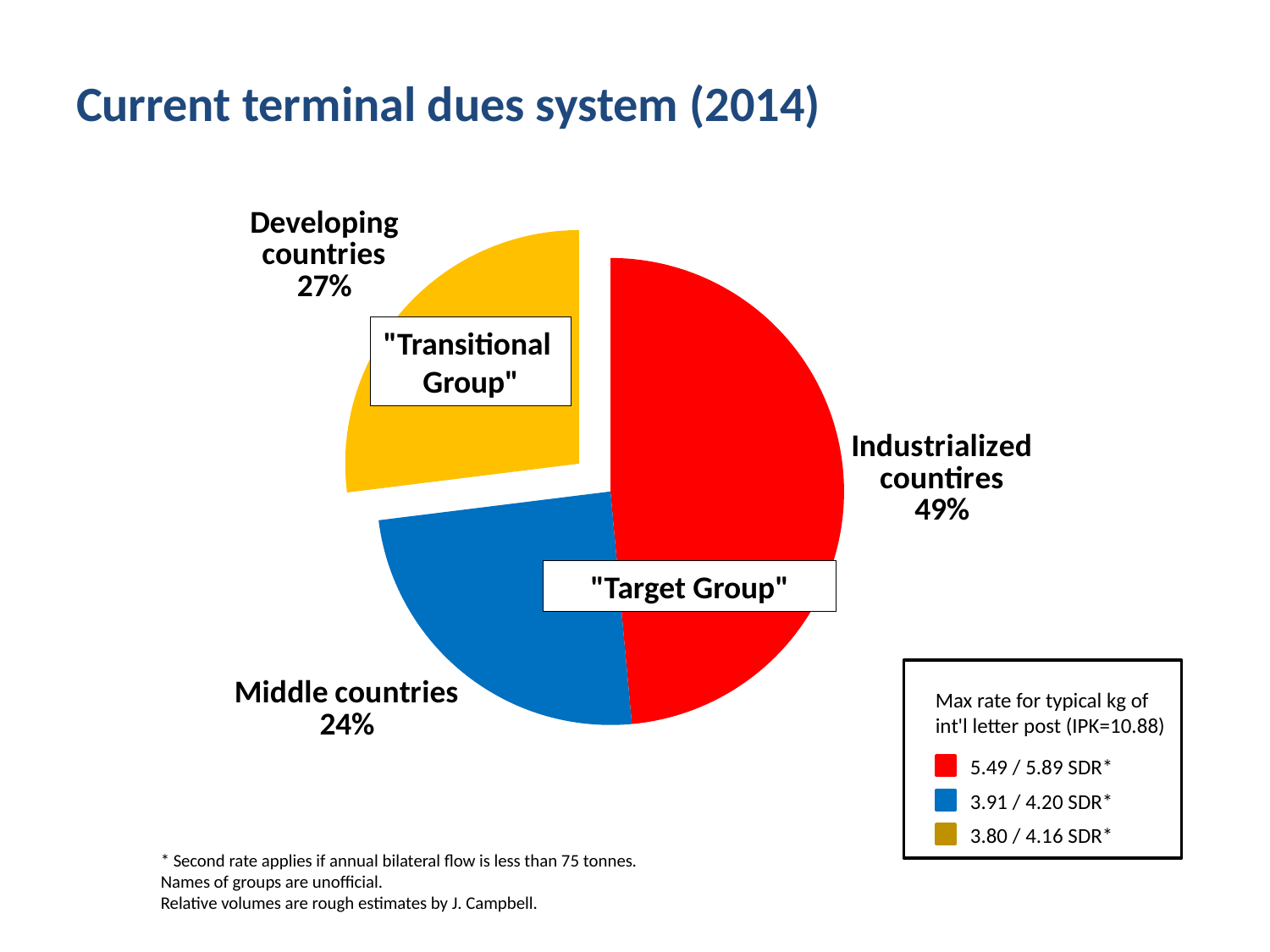
How many slices does the pie chart have? 3 Which slice is larger, Developing countries or Middle countries? Developing countries What is the difference in percentage points between the Developing countries slice and the Middle countries slice? 3 What is the difference in percentage points between the Industrialized countries slice and the Developing countries slice? 22 What share of the pie do Middle countries account for? 24% What colour is the Middle countries slice? Blue What kind of chart is shown on the slide? Pie chart Which category has the smallest slice of the pie? Middle countries What is the title of the slide containing the chart? Current terminal dues system (2014) Which category has the largest slice of the pie? Industrialized countries What share of the pie do Developing countries account for? 27% What share of the pie do Industrialized countries account for? 49%